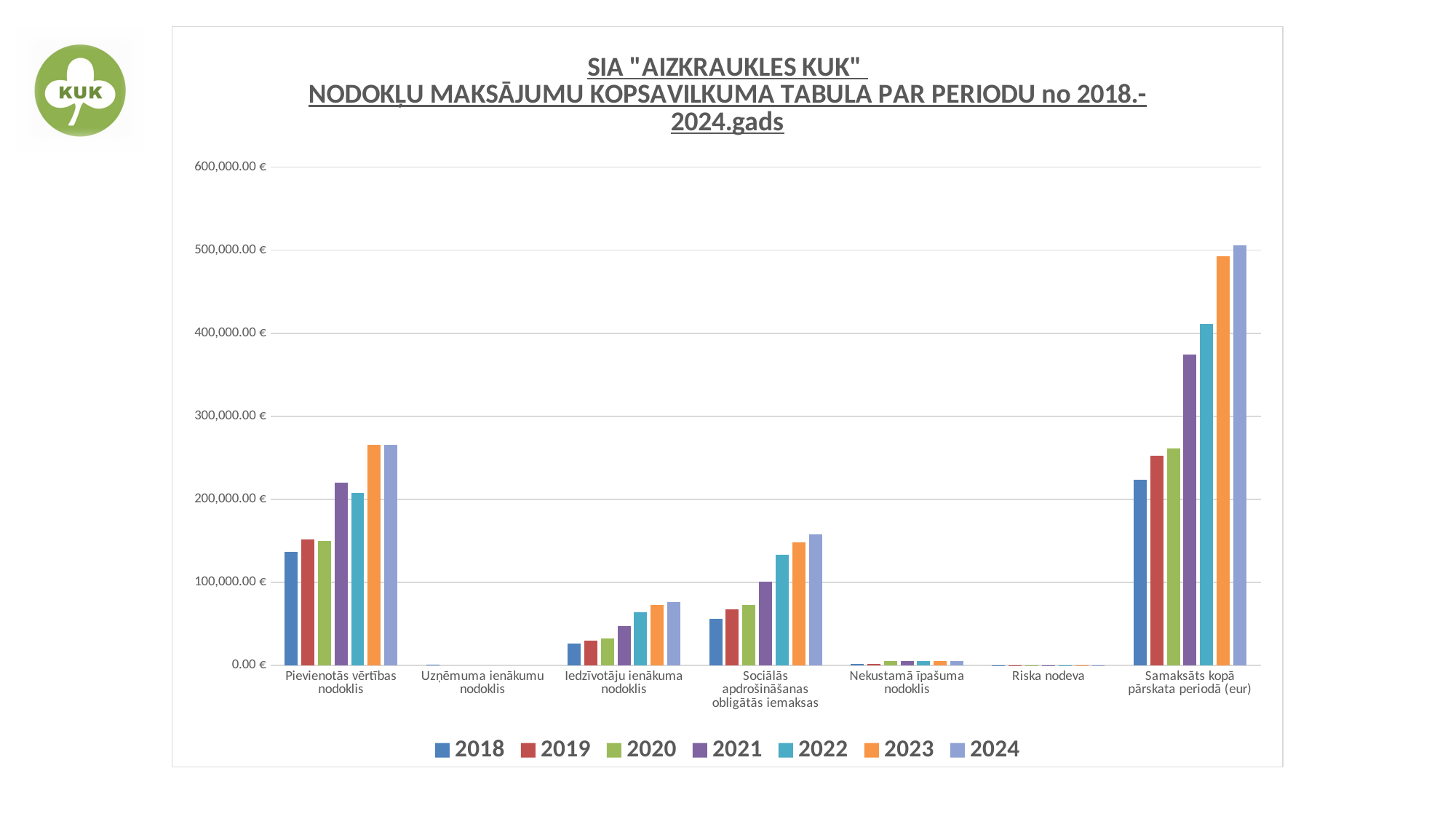
Which category has the tallest bars on the chart? Samaksāts kopā pārskata periodā (eur) How many tax categories are shown along the x axis? 7 Is the 2018 value for Pievienotās vērtības nodoklis greater or less than 100,000.00 €? greater For 2024, which is larger: Sociālās apdrošināšanas obligātās iemaksas or Iedzīvotāju ienākuma nodoklis? Sociālās apdrošināšanas obligātās iemaksas Is the 2023 value for Samaksāts kopā pārskata periodā (eur) greater or less than 400,000.00 €? greater How many series (years) does the legend list? 7 What kind of chart is shown on the slide? Bar chart Which year has the lowest bar for Sociālās apdrošināšanas obligātās iemaksas? 2018 Is the 2018 value for Iedzīvotāju ienākuma nodoklis greater or less than 100,000.00 €? less Do the values for Samaksāts kopā pārskata periodā (eur) rise or fall from 2018 to 2024? Rise What colour represents 2023 in the legend? Orange